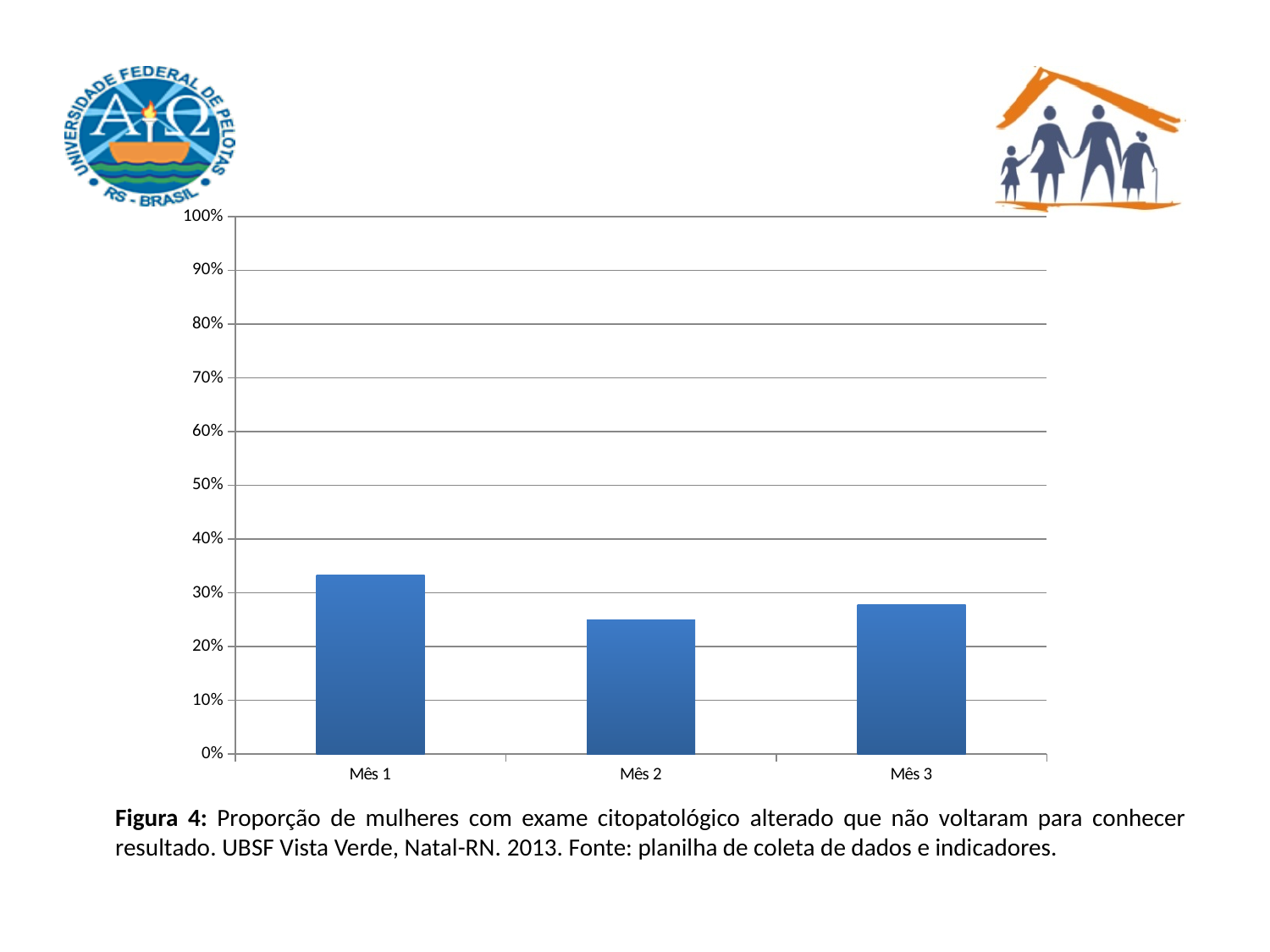
Does the value rise or fall from Mês 1 to Mês 2? fall Is the value for Mês 2 greater or less than 20%? greater What is the figure number given in the caption below the chart? Figura 4 How many categories are plotted on the x axis? 3 Is the value for Mês 1 greater or less than 40%? less What kind of chart is shown on the slide? bar chart Is the value for Mês 3 greater or less than 30%? less Which category has the lowest bar? Mês 2 Which category has the highest bar? Mês 1 Which is larger, the value for Mês 1 or the value for Mês 2? Mês 1